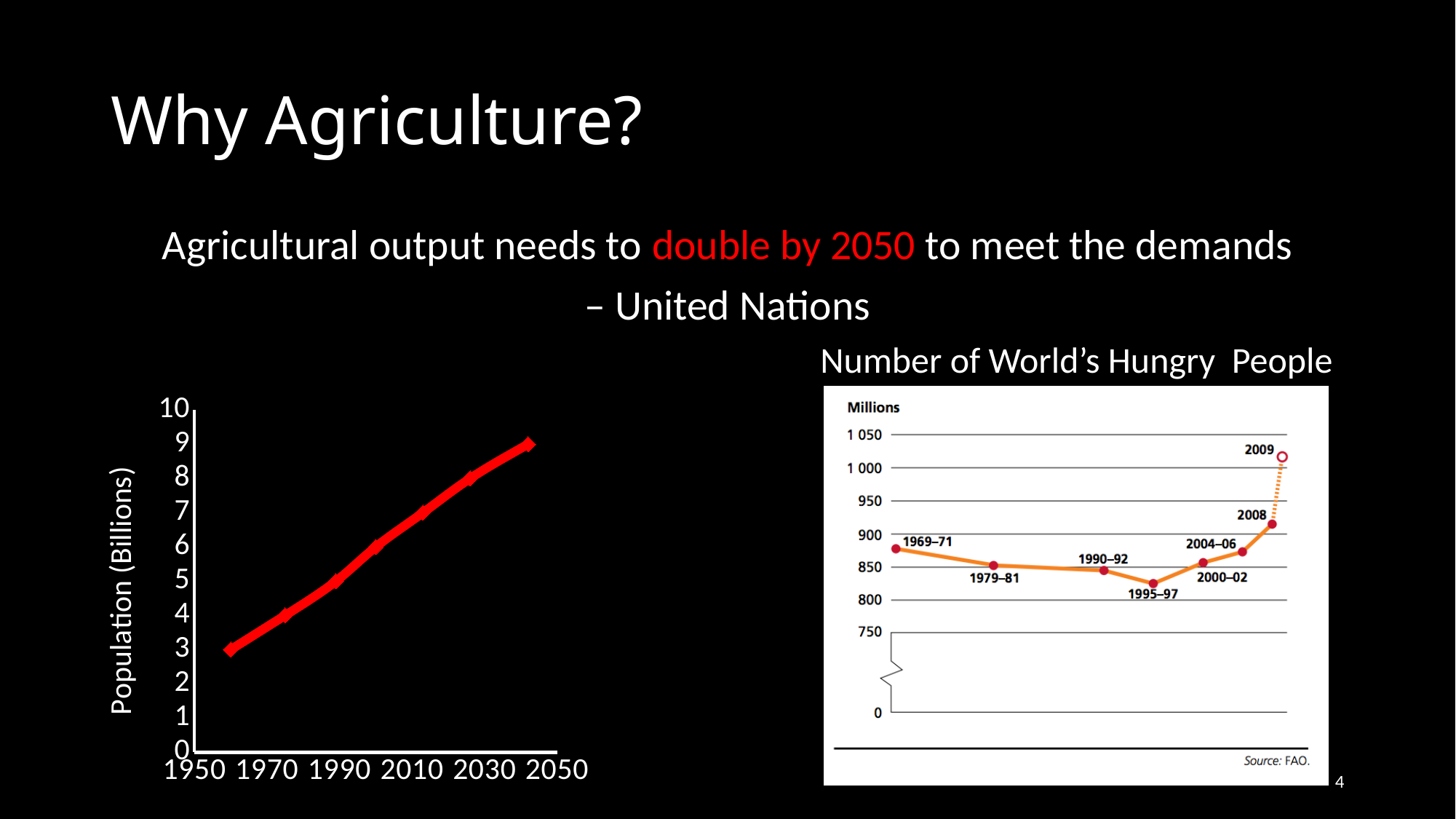
What is the y-axis label of the left population chart? Population (Billions) In the 'Number of World's Hungry People' chart, which period has the lowest value? 1995–97 In the 'Number of World's Hungry People' chart, is the value for 2009 greater or less than 1 000? greater How many data points are plotted on the left population chart? 7 In the 'Number of World's Hungry People' chart, is the value for 1995–97 greater or less than 850? less How many data points are plotted on the 'Number of World's Hungry People' chart? 8 In the 'Number of World's Hungry People' chart, which is larger: the value for 1969–71 or for 1979–81? 1969–71 What type of chart is the left chart showing population? line chart In the left population chart, is the value at the left end of the line greater or less than 5? less In the left population chart, do the values rise or fall from 1950 toward 2050? rise In the 'Number of World's Hungry People' chart, which year has the highest value? 2009